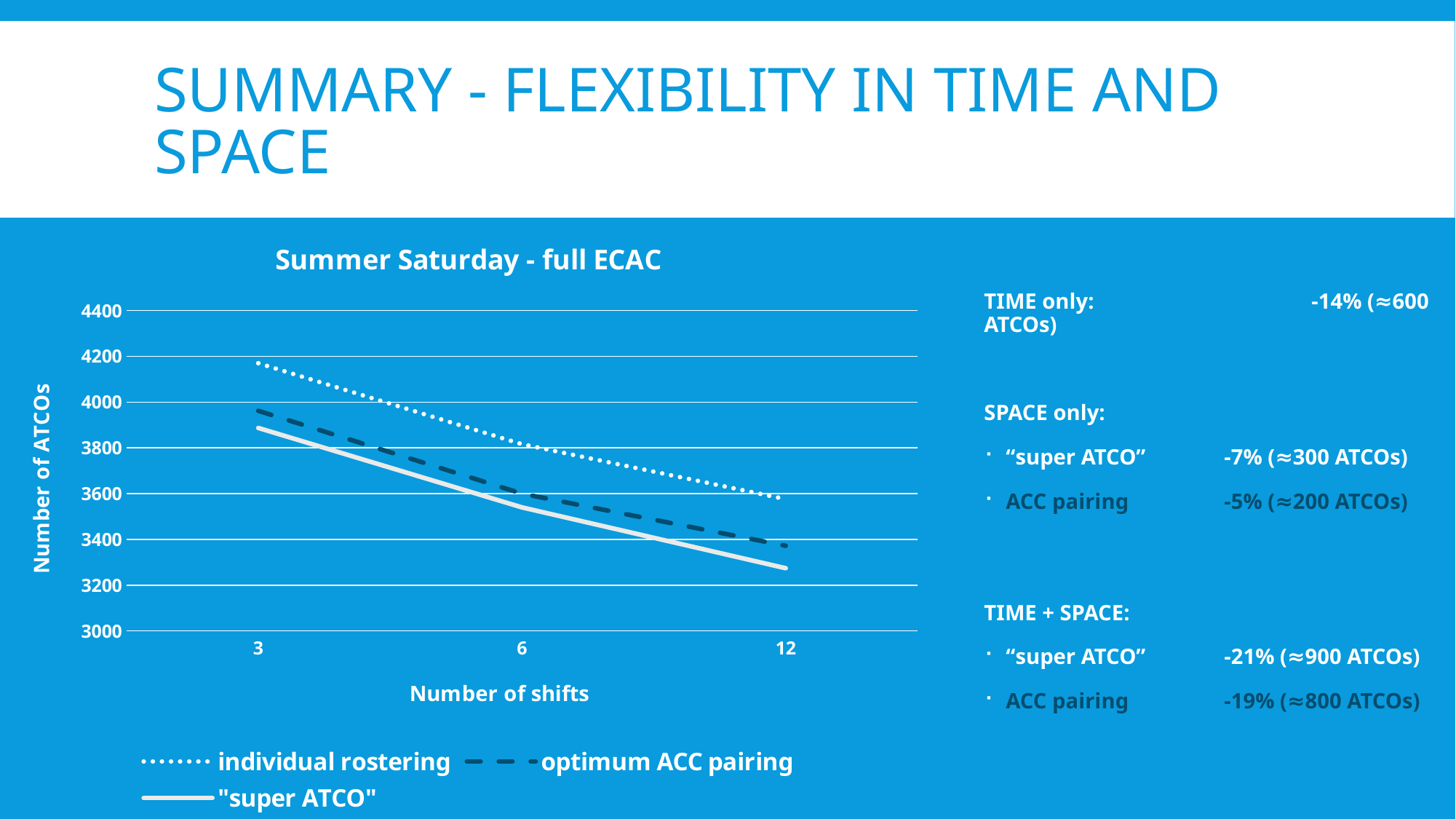
Is the value for "super ATCO" at 12 shifts greater or less than 3400? less What kind of chart is shown on the slide? line chart Which series has the lowest number of ATCOs at 12 shifts? "super ATCO" Which series has the highest number of ATCOs at 3 shifts? individual rostering Do the values for individual rostering rise or fall as the number of shifts increases? fall At 6 shifts, which is larger: individual rostering or "super ATCO"? individual rostering What is the label of the y axis? Number of ATCOs How many values for number of shifts are plotted on the x axis? 3 How many series does the chart legend list? 3 Is the value for optimum ACC pairing at 12 shifts greater or less than 3600? less Is the value for individual rostering at 3 shifts greater or less than 4000? greater What is the title of the chart? Summer Saturday - full ECAC